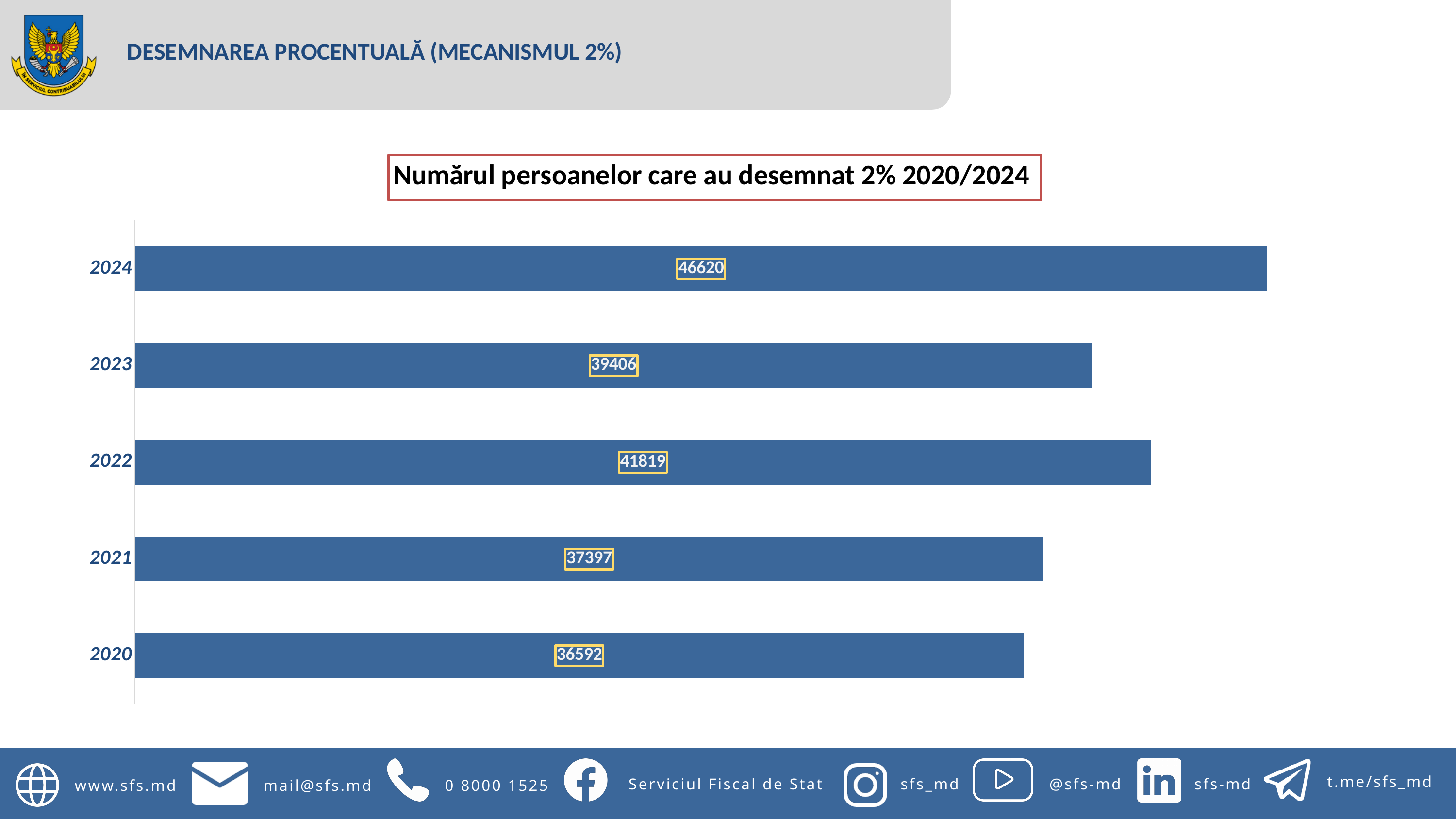
What is the difference between the values for 2024 and 2023? 7214 What is the value for 2020? 36592 What is the value for 2022? 41819 Which year has the lowest value? 2020 What is the title of the chart? Numărul persoanelor care au desemnat 2% 2020/2024 What kind of chart is shown on the slide? bar chart What colour are the bars in the chart? blue Which year has the highest value? 2024 How many years are shown in the chart? 5 What is the value for 2024? 46620 Which is larger, the value for 2022 or the value for 2023? 2022 What is the difference between the values for 2021 and 2020? 805